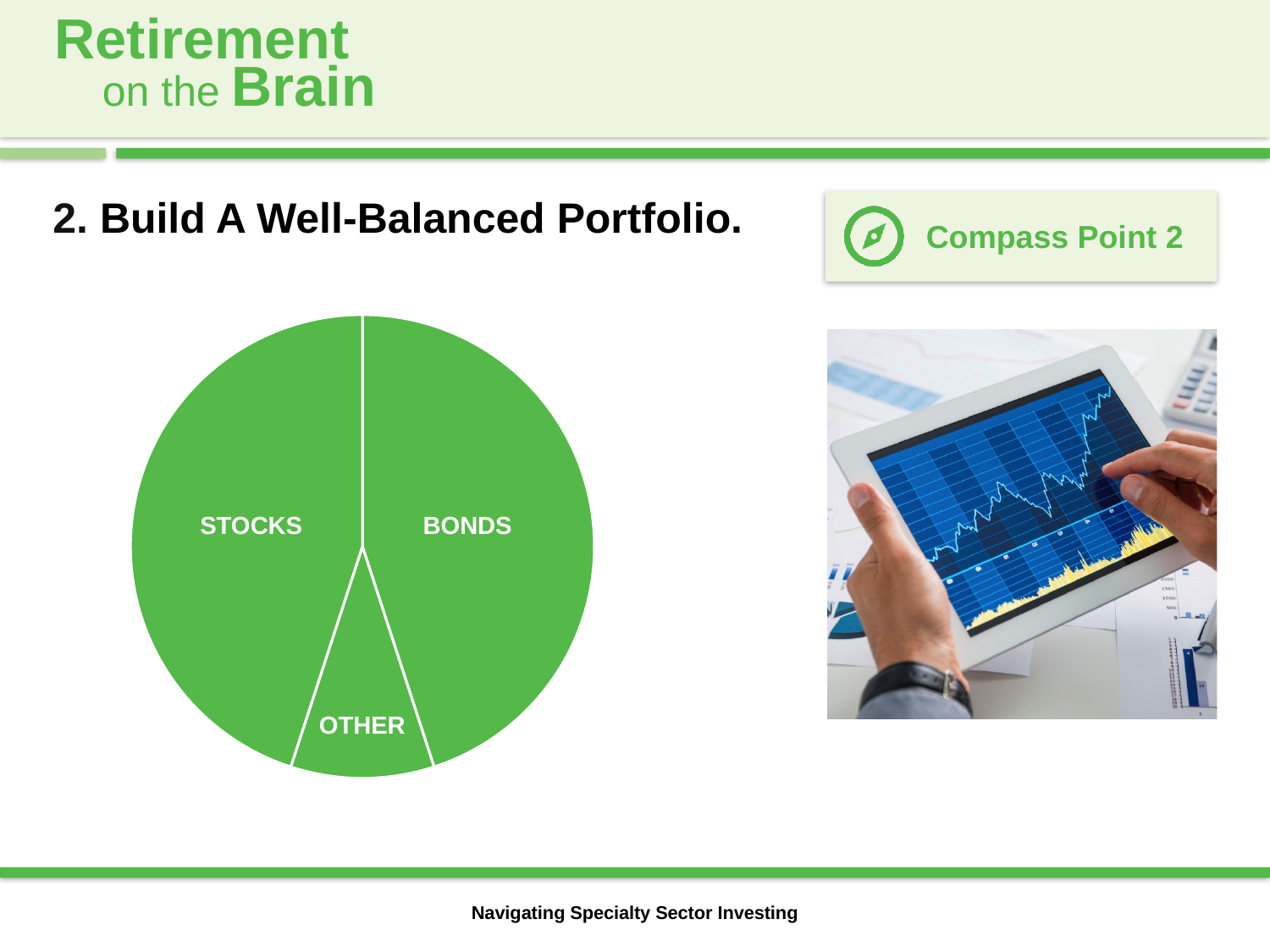
What are the labels of the three slices in the pie chart? STOCKS, BONDS, OTHER Which slice is larger in the pie chart, STOCKS or OTHER? STOCKS What kind of chart is shown on the slide? pie chart What colour are the slices of the pie chart? green How many slices does the pie chart have? 3 Which slice is larger in the pie chart, BONDS or OTHER? BONDS Which slice of the pie chart is the smallest? OTHER